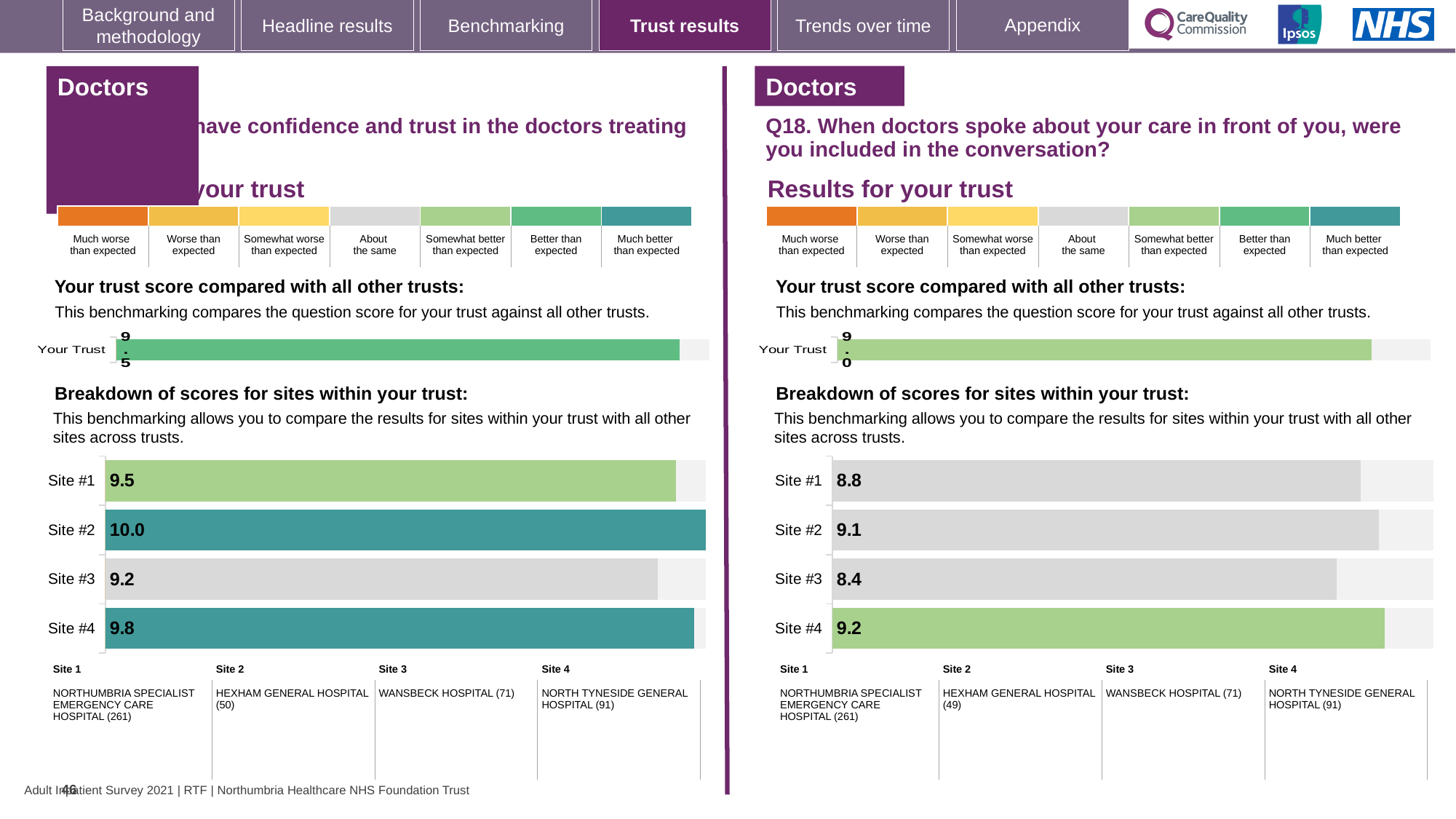
On the right-hand chart (Q18), which site has the highest score? Site #4 On the right-hand chart (Q18), what is the score for Site #3? 8.4 On the right-hand chart (Q18), what is the difference between the scores for Site #4 and Site #3? 0.8 On the right-hand chart (Q18), what is the 'Your Trust' score shown in the trust comparison bar? 9.0 What kind of chart is used for the site breakdown on the left-hand side of the slide? Bar chart On the right-hand chart (Q18), which site has the lowest score? Site #3 On the left-hand site breakdown chart, what is the difference between the scores for Site #2 and Site #3? 0.8 How many sites are shown in the right-hand site breakdown chart (Q18)? 4 On the right-hand chart (Q18), what is the score for Site #1? 8.8 On the left-hand site breakdown chart, which is larger: the score for Site #4 or Site #1? Site #4 On the left-hand site breakdown chart, what is the score for Site #2? 10.0 On the left-hand site breakdown chart, which site has the highest score? Site #2